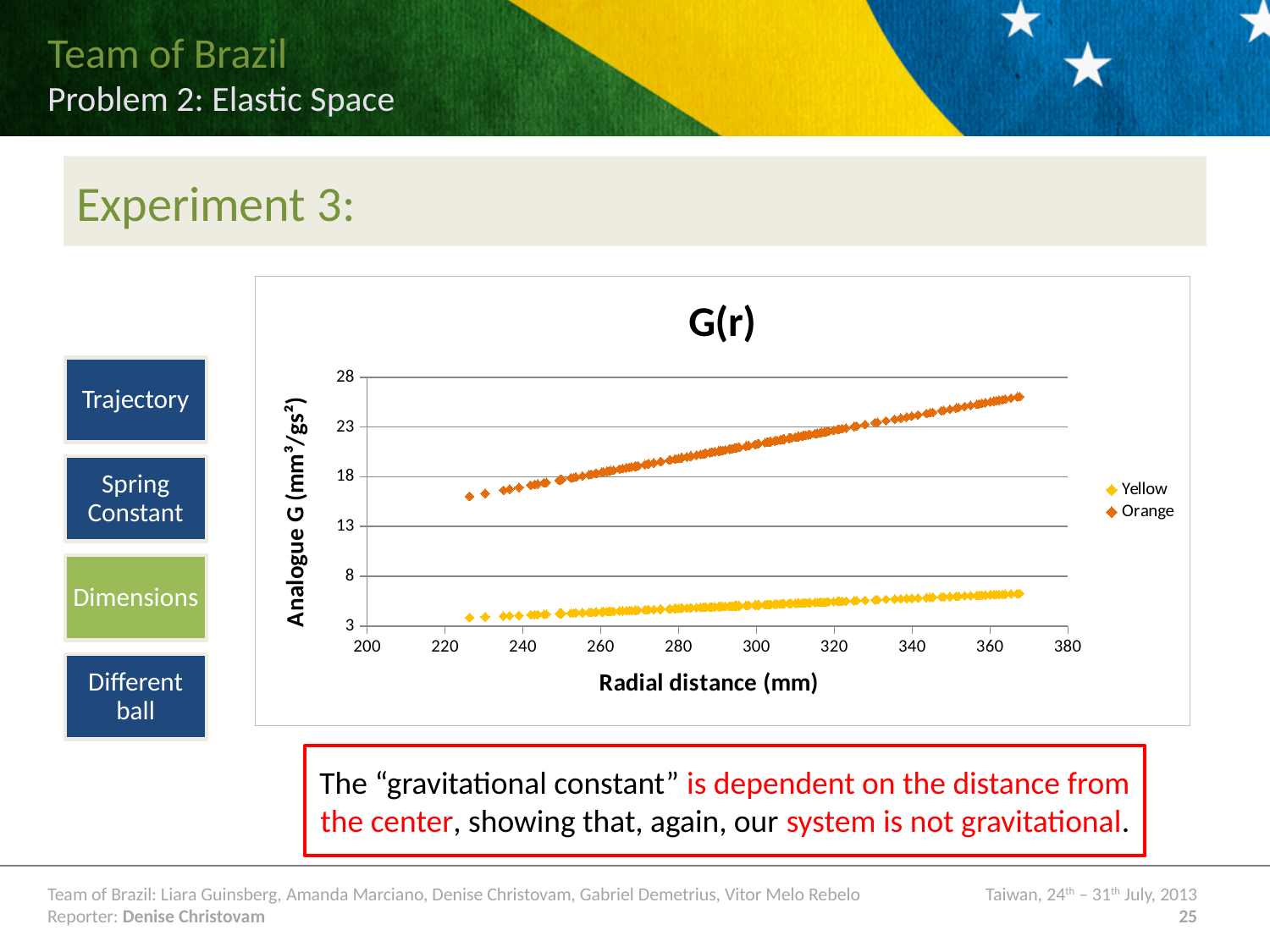
Is the value of the Yellow series at a radial distance of 360 mm greater or less than 8? less Do the values of the Orange series rise or fall as radial distance increases? rise How many series does the chart's legend list? 2 Is the value of the Orange series at a radial distance of 240 mm greater or less than 18? less Which series has the lower values at a radial distance of 280 mm, Yellow or Orange? Yellow Is the value of the Orange series at a radial distance of 300 mm greater or less than 18? greater What is the title of the chart? G(r) Do the values of the Yellow series rise or fall as radial distance increases? rise Which series has the higher values across the plotted range, Yellow or Orange? Orange What kind of chart is shown on the slide? scatter chart What are the two series named in the legend? Yellow and Orange